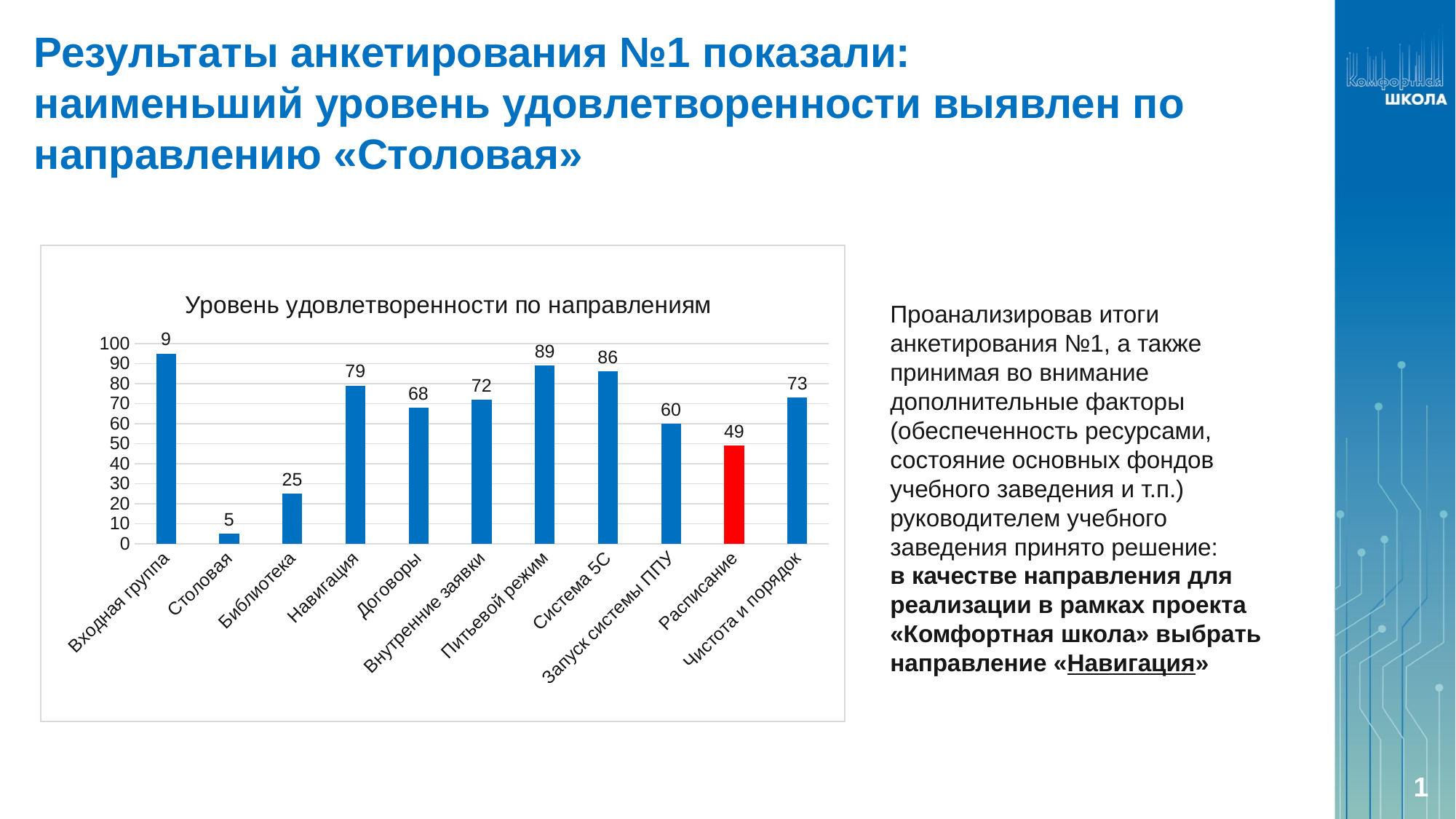
What is the value for Расписание? 49 What is the difference between the values for Навигация and Договоры? 11 What kind of chart is shown? bar chart What is the value for Столовая? 5 Which category has the lowest value? Столовая What is the value for Навигация? 79 What is the value for Чистота и порядок? 73 Which category's bar is coloured red? Расписание How many categories are shown on the x axis? 11 Is the value for Входная группа greater or less than 90? greater What is the title of the chart? Уровень удовлетворенности по направлениям Which is larger, the value for Питьевой режим or the value for Система 5С? Питьевой режим